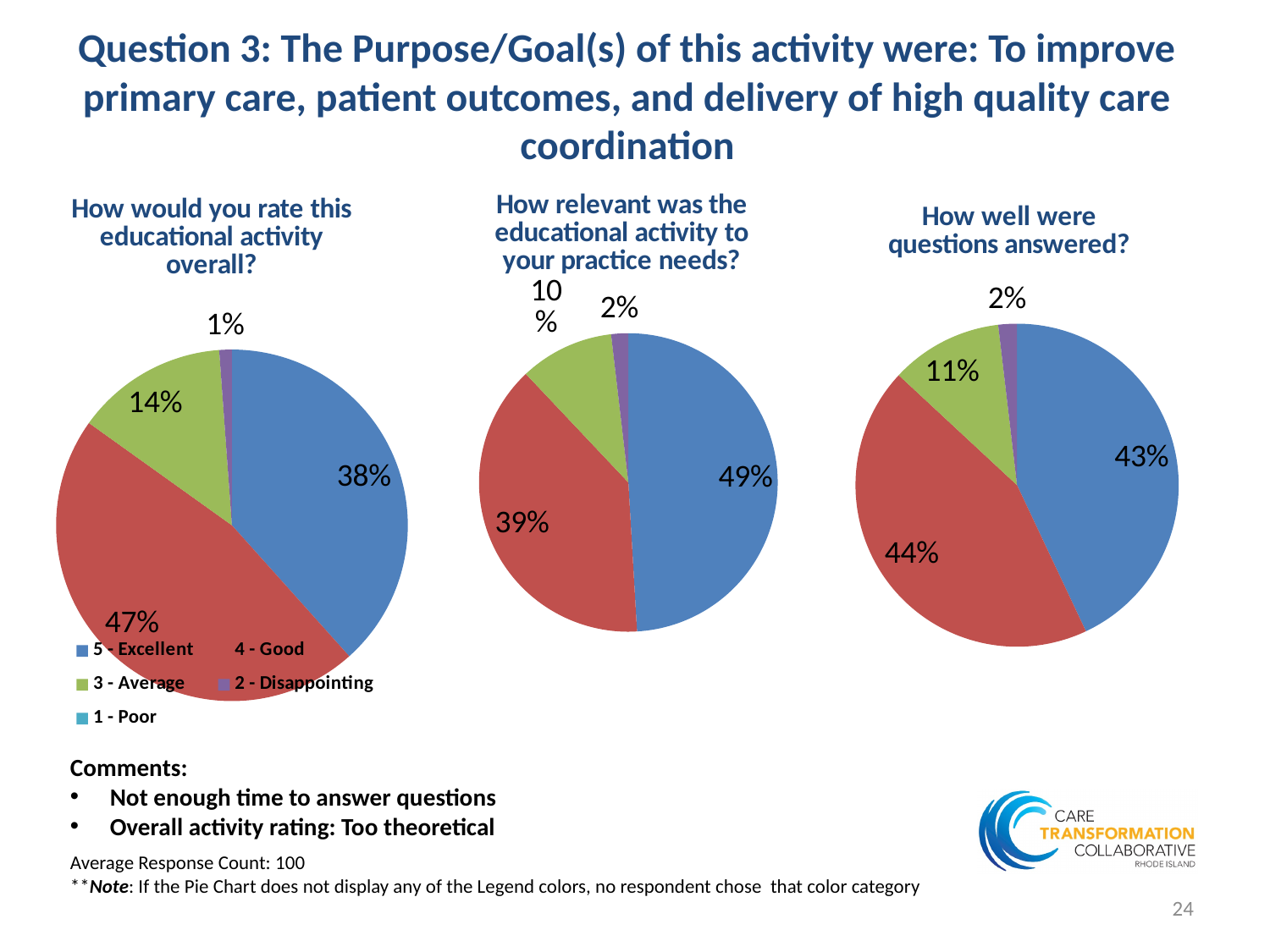
What type of chart is used for 'How well were questions answered?' Pie chart In the 'How would you rate this educational activity overall?' chart, what is the difference between the 4 - Good share and the 5 - Excellent share? 9% In the 'How would you rate this educational activity overall?' chart, what share is labelled for the 4 - Good slice? 47% In the 'How relevant was the educational activity to your practice needs?' chart, which rating category has the smallest slice? 2 - Disappointing In the 'How well were questions answered?' chart, which rating category has the largest slice? 4 - Good How many charts are shown on the slide? 3 How many rating categories does the legend list? 5 In the 'How well were questions answered?' chart, what share is labelled for the 3 - Average slice? 11% In the 'How well were questions answered?' chart, which is larger: the 5 - Excellent slice or the 4 - Good slice? 4 - Good In the 'How would you rate this educational activity overall?' chart, what share is labelled for the 3 - Average slice? 14% In the 'How relevant was the educational activity to your practice needs?' chart, what share is labelled for the 5 - Excellent slice? 49% In the 'How relevant was the educational activity to your practice needs?' chart, what is the combined share of the 5 - Excellent and 4 - Good slices? 88%